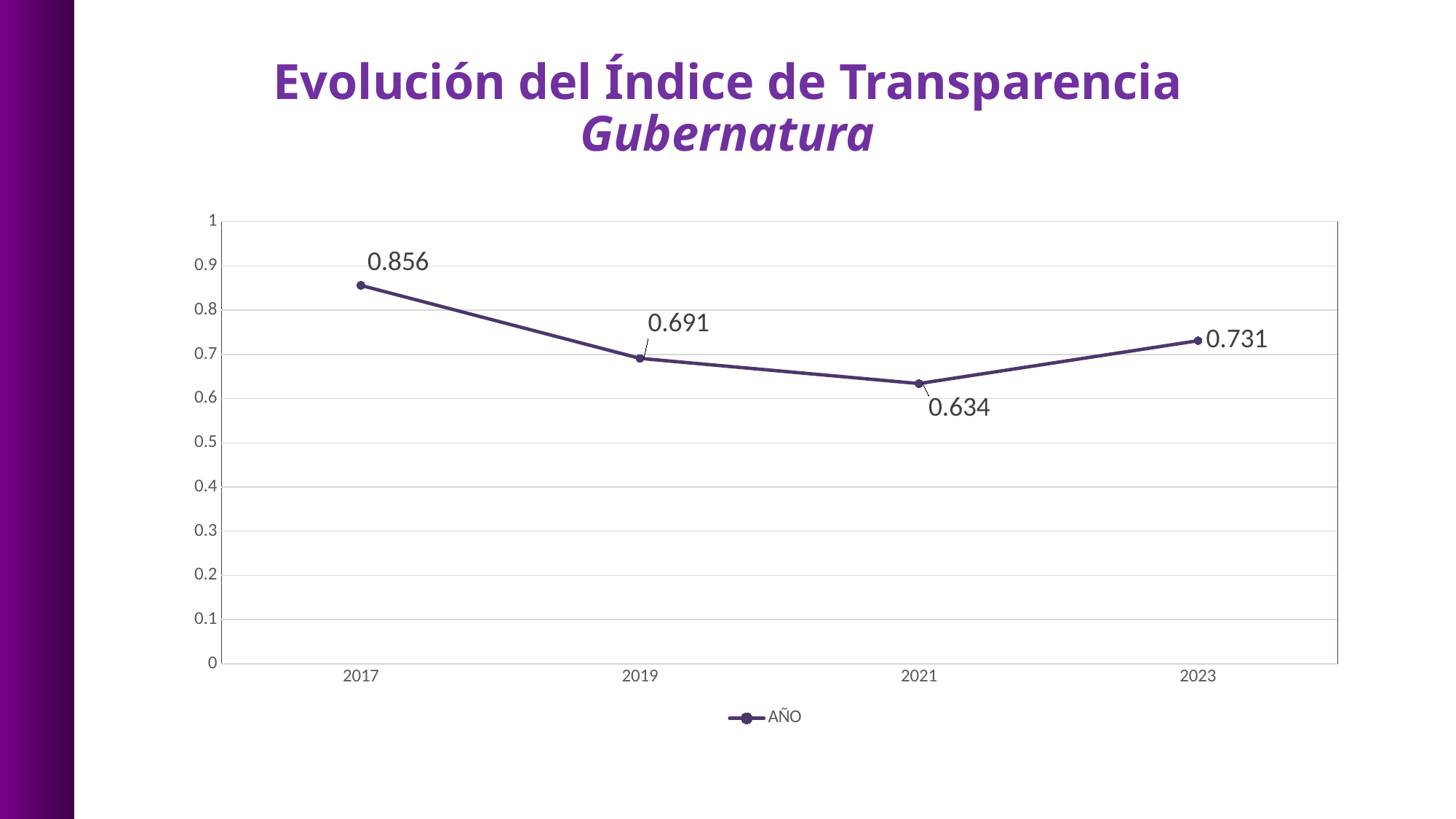
What is the name of the series shown in the legend? AÑO What is the value for 2019? 0.691 Which year has the lowest value? 2021 What is the value for 2021? 0.634 What is the difference between the values for 2017 and 2021? 0.222 Which is larger, the value for 2019 or the value for 2023? 2023 What is the value for 2023? 0.731 How many years are plotted on the x axis? 4 Is the value for 2021 greater or less than 0.7? less Which year has the highest value? 2017 What kind of chart is shown? line chart What is the value for 2017? 0.856